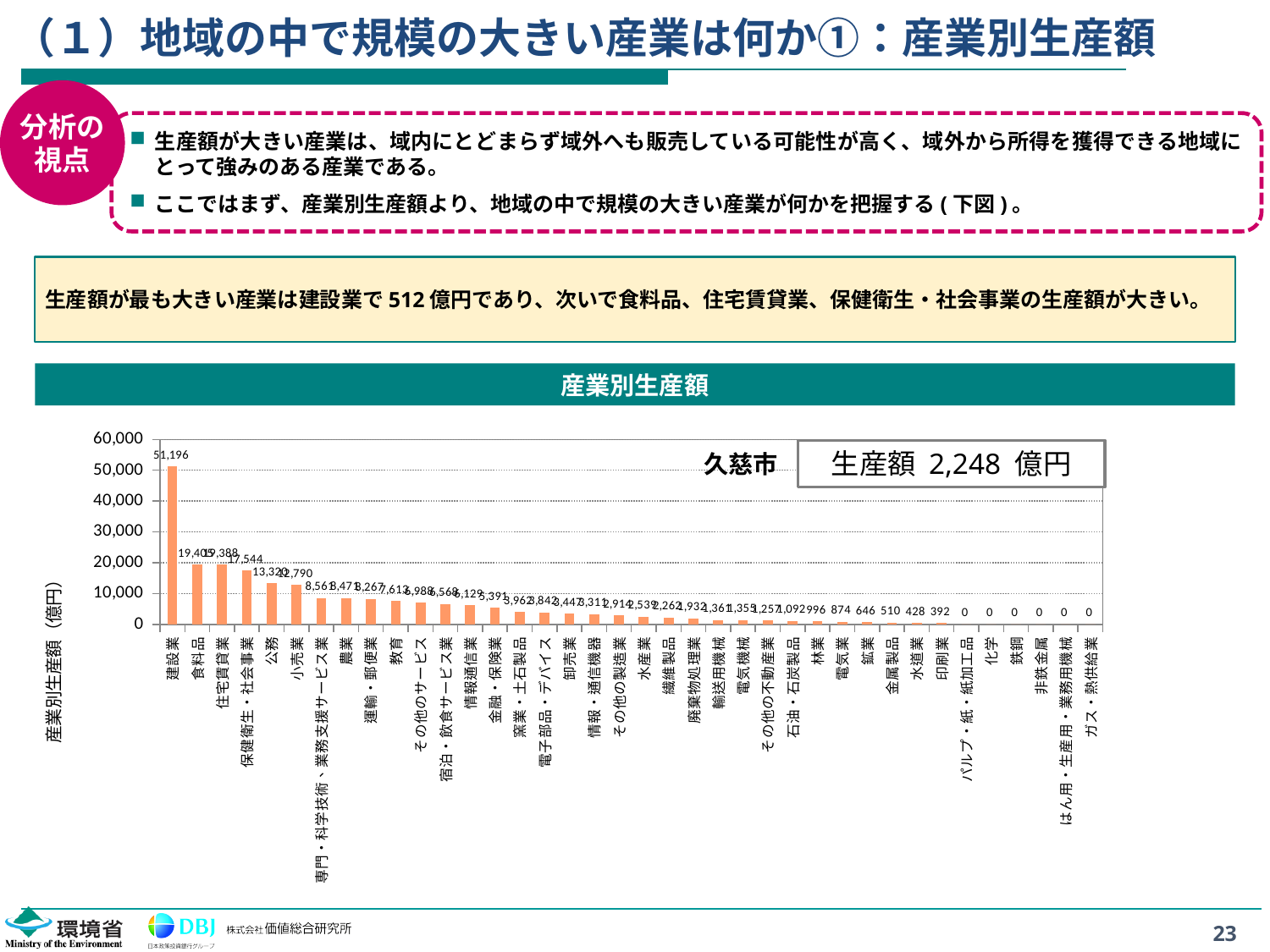
What is the value for 林業? 996 What is the value for 建設業? 51,196 Do the values rise or fall moving from left to right along the x axis? fall How many industries have a value of 0? 6 What is the value for 印刷業? 392 Which is larger, the value for 小売業 or the value for 教育? 小売業 Which industry has the highest value? 建設業 What is the difference between the values for 鉱業 and 金属製品? 136 Is the value for 食料品 greater or less than 10,000? greater What is the value for 金融・保険業? 5,391 What type of chart is shown under the title 産業別生産額? bar chart What is the value for 保健衛生・社会事業? 17,544